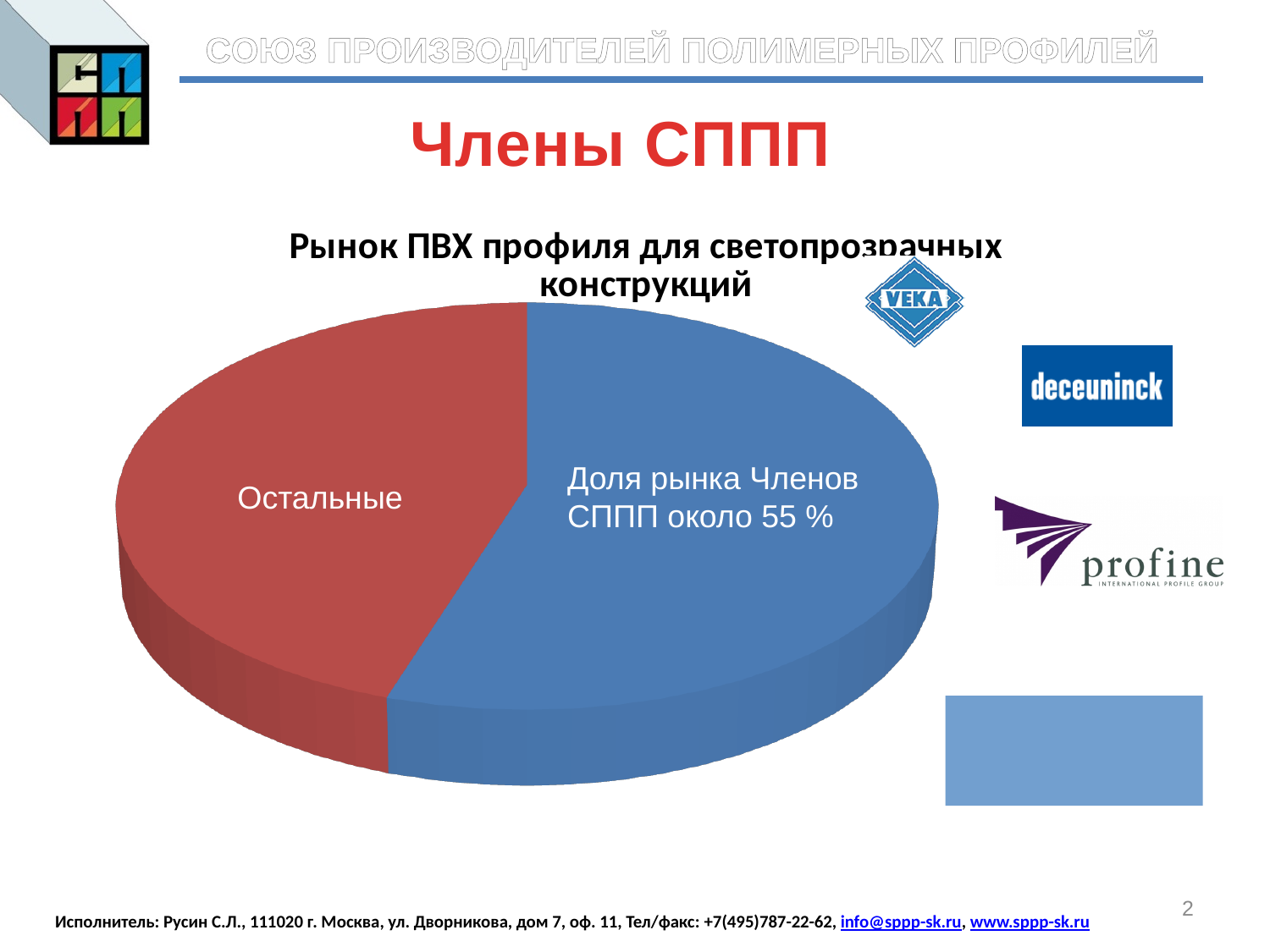
What is the title of the pie chart? Рынок ПВХ профиля для светопрозрачных конструкций What colour is the Остальные slice of the pie chart? red Which slice of the pie chart is the smallest? Остальные How many slices does the pie chart have? 2 What kind of chart is shown on the slide? pie chart Which slice of the pie chart is the largest? Доля рынка Членов СППП Which slice is larger: Остальные or Доля рынка Членов СППП? Доля рынка Членов СППП